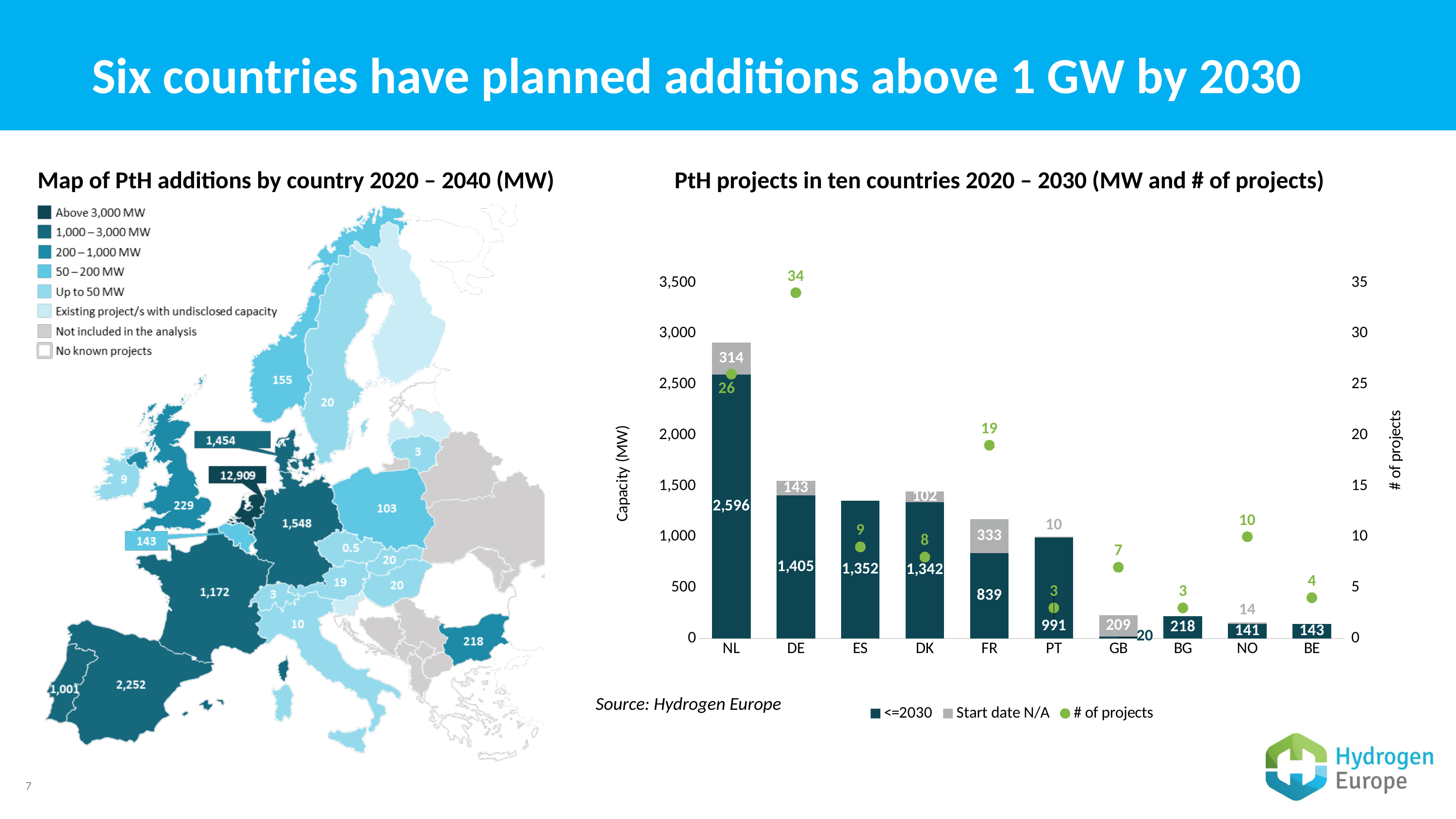
In the chart 'PtH projects in ten countries 2020 – 2030', which has the larger <=2030 capacity, FR or PT? PT In the chart 'PtH projects in ten countries 2020 – 2030', how many series does the legend list? 3 In the map 'Map of PtH additions by country 2020 – 2040 (MW)', what value is shown for Spain? 2,252 In the chart 'PtH projects in ten countries 2020 – 2030', which country has the highest number of projects? DE In the chart 'PtH projects in ten countries 2020 – 2030', what is the <=2030 capacity value for NL? 2,596 In the chart 'PtH projects in ten countries 2020 – 2030', what is the difference between the <=2030 values for DE and ES? 53 In the chart 'PtH projects in ten countries 2020 – 2030', what is the total stacked capacity for NL (<=2030 plus Start date N/A)? 2,910 What kind of chart is 'PtH projects in ten countries 2020 – 2030'? bar chart In the chart 'PtH projects in ten countries 2020 – 2030', which country has the lowest <=2030 capacity? GB In the chart 'PtH projects in ten countries 2020 – 2030', how many projects are shown for DE? 34 In the chart 'PtH projects in ten countries 2020 – 2030', what is the Start date N/A value for FR? 333 In the chart 'PtH projects in ten countries 2020 – 2030', how many countries are shown on the x axis? 10